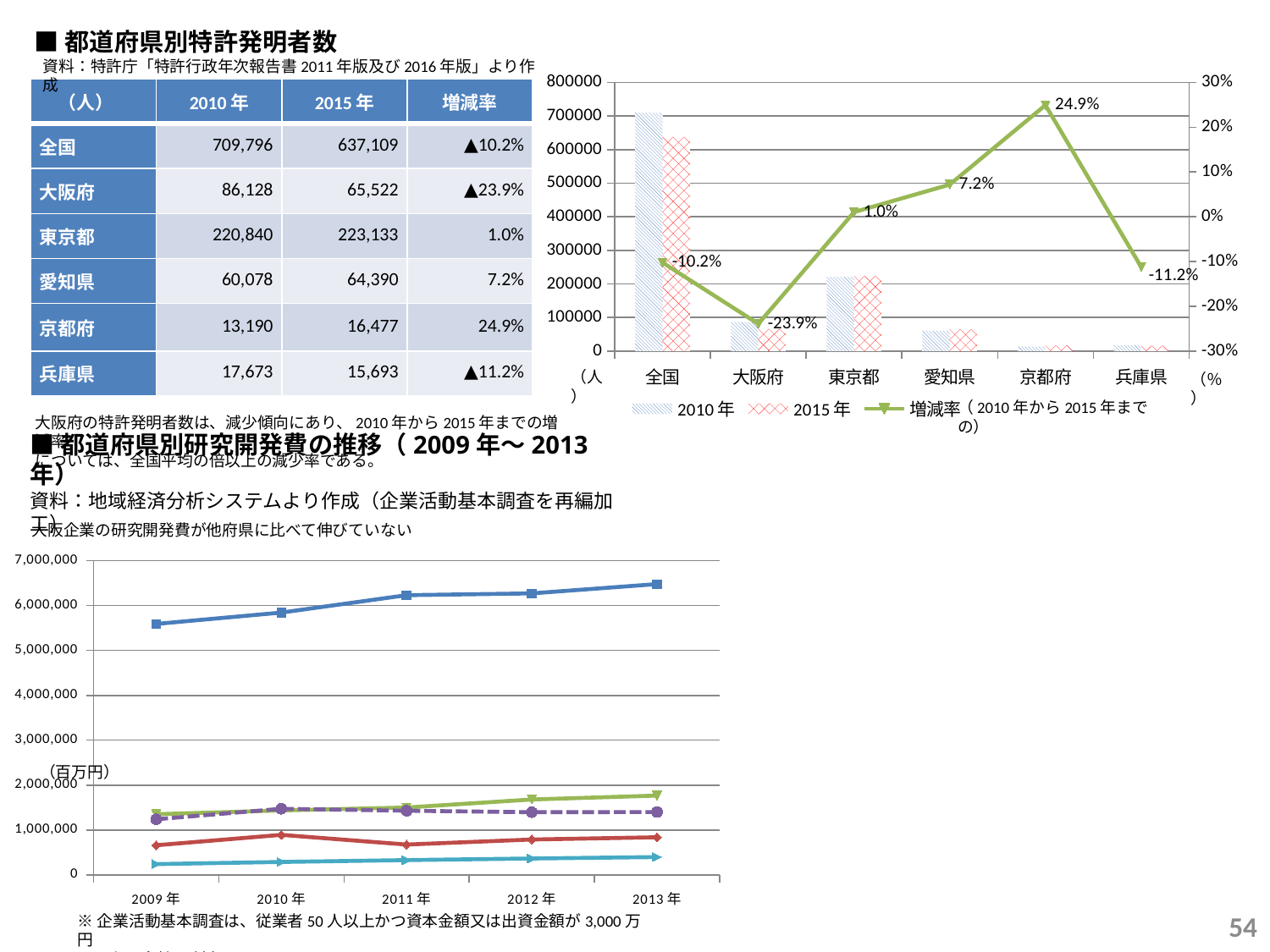
In the top-right chart, is the change rate for 東京都 or 愛知県 larger? 愛知県 In the top-right chart, is the 2010年 bar for 全国 greater or less than 600000? greater In the top-right chart, how many series does the legend list? 3 In the bottom chart (都道府県別研究開発費の推移), does the topmost line rise or fall from 2009年 to 2013年? rise In the top-right chart, how many prefecture categories are shown on the x axis? 6 In the bottom chart (都道府県別研究開発費の推移), how many years are plotted on the x axis? 5 In the top-right chart, what is the change rate (増減率) shown for 全国? -10.2% In the top-right chart, what is the change rate (増減率) shown for 大阪府? -23.9% In the top-right chart, which prefecture has the highest change rate (増減率)? 京都府 In the top-right chart, which category has the lowest change rate (増減率)? 大阪府 In the top-right chart, what is the difference between the change rates of 京都府 and 愛知県? 17.7 percentage points In the top-right chart, what is the change rate (増減率) shown for 京都府? 24.9%